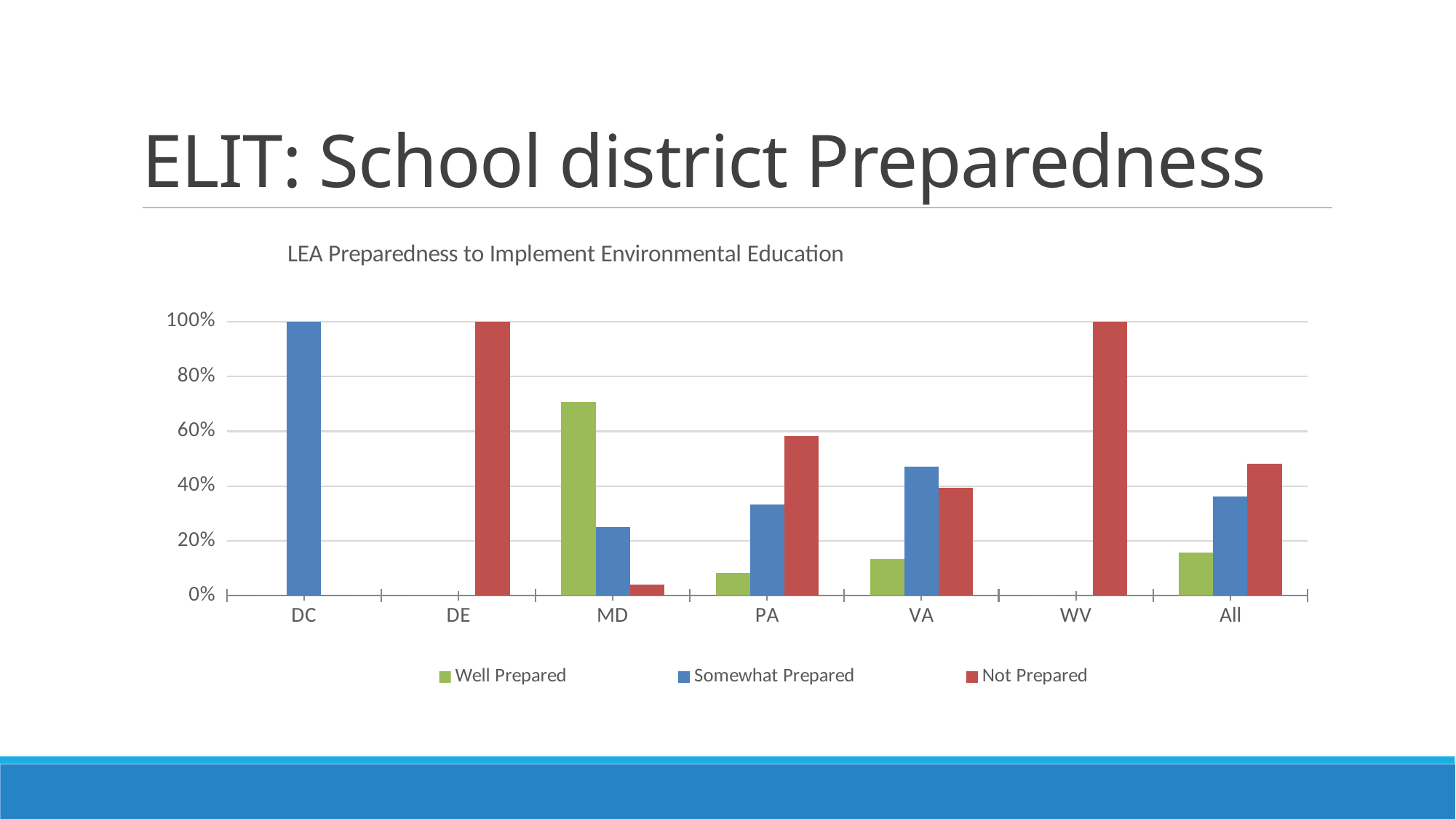
Which category has the highest Well Prepared value? MD What is the Not Prepared value for DE? 100% How many series does the legend list? 3 What is the title of the chart? LEA Preparedness to Implement Environmental Education What is the Somewhat Prepared value for DC? 100% How many categories are shown on the x axis? 7 Is the Well Prepared value for MD greater or less than 60%? greater What is the Not Prepared value for WV? 100% Is the Not Prepared value for PA greater or less than 40%? greater Is the Somewhat Prepared value for VA greater or less than 40%? greater For MD, which is larger: Well Prepared or Somewhat Prepared? Well Prepared What kind of chart is shown on the slide? bar chart